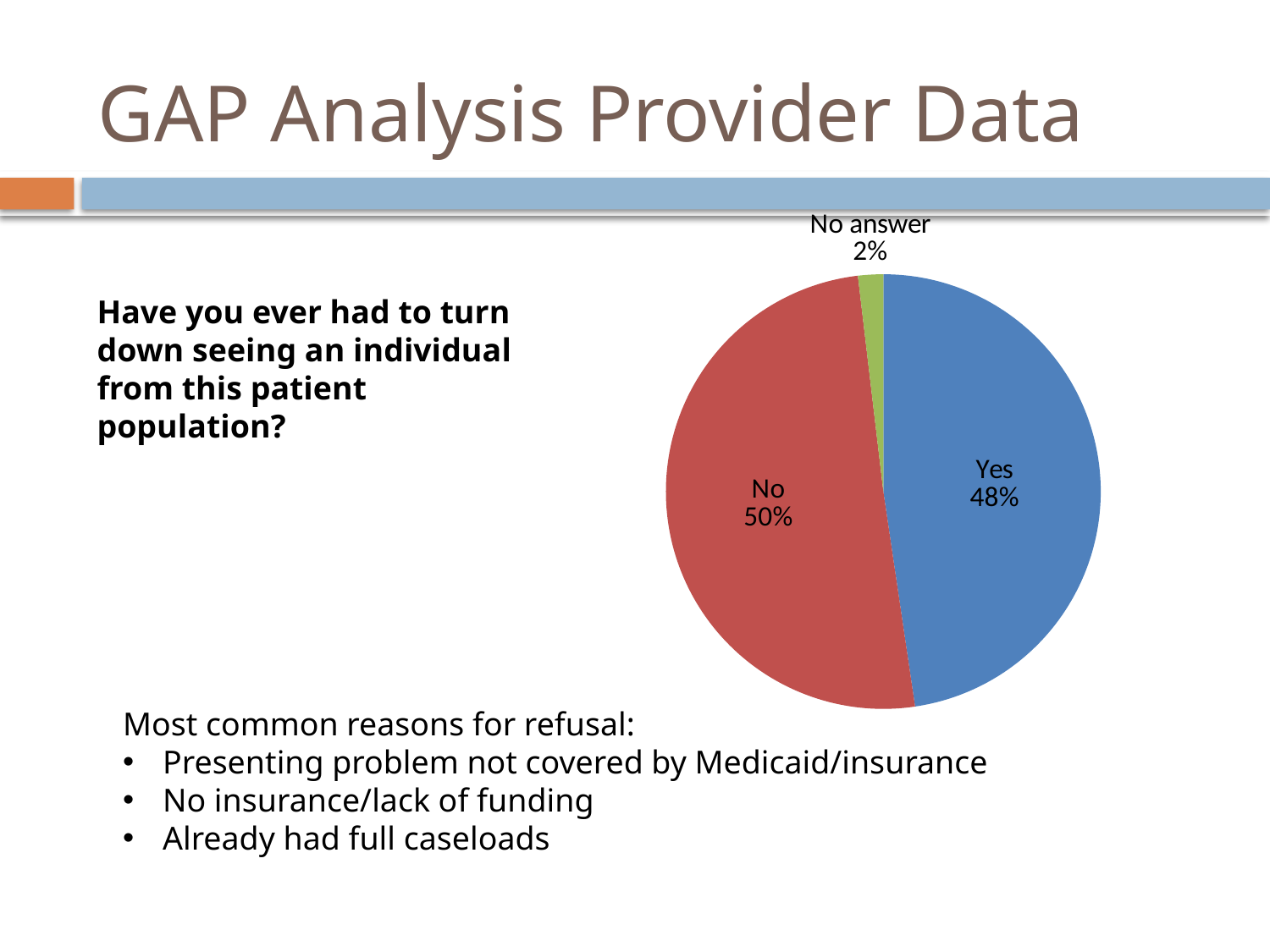
Which slice is larger, "Yes" or "No answer"? Yes What percentage of providers answered "No" in the pie chart? 50% What share of the pie chart is labelled "No answer"? 2% What survey question does the pie chart summarise? Have you ever had to turn down seeing an individual from this patient population? What kind of chart is shown on the slide? Pie chart What percentage of providers answered "Yes" in the pie chart? 48% What is the difference in percentage points between the "No" and "Yes" slices? 2 How many slices does the pie chart have? 3 What colour is the "No" slice in the pie chart? Red Which response has the smallest slice in the pie chart? No answer What is the combined share of the "Yes" and "No" slices? 98% Which response has the largest slice in the pie chart? No